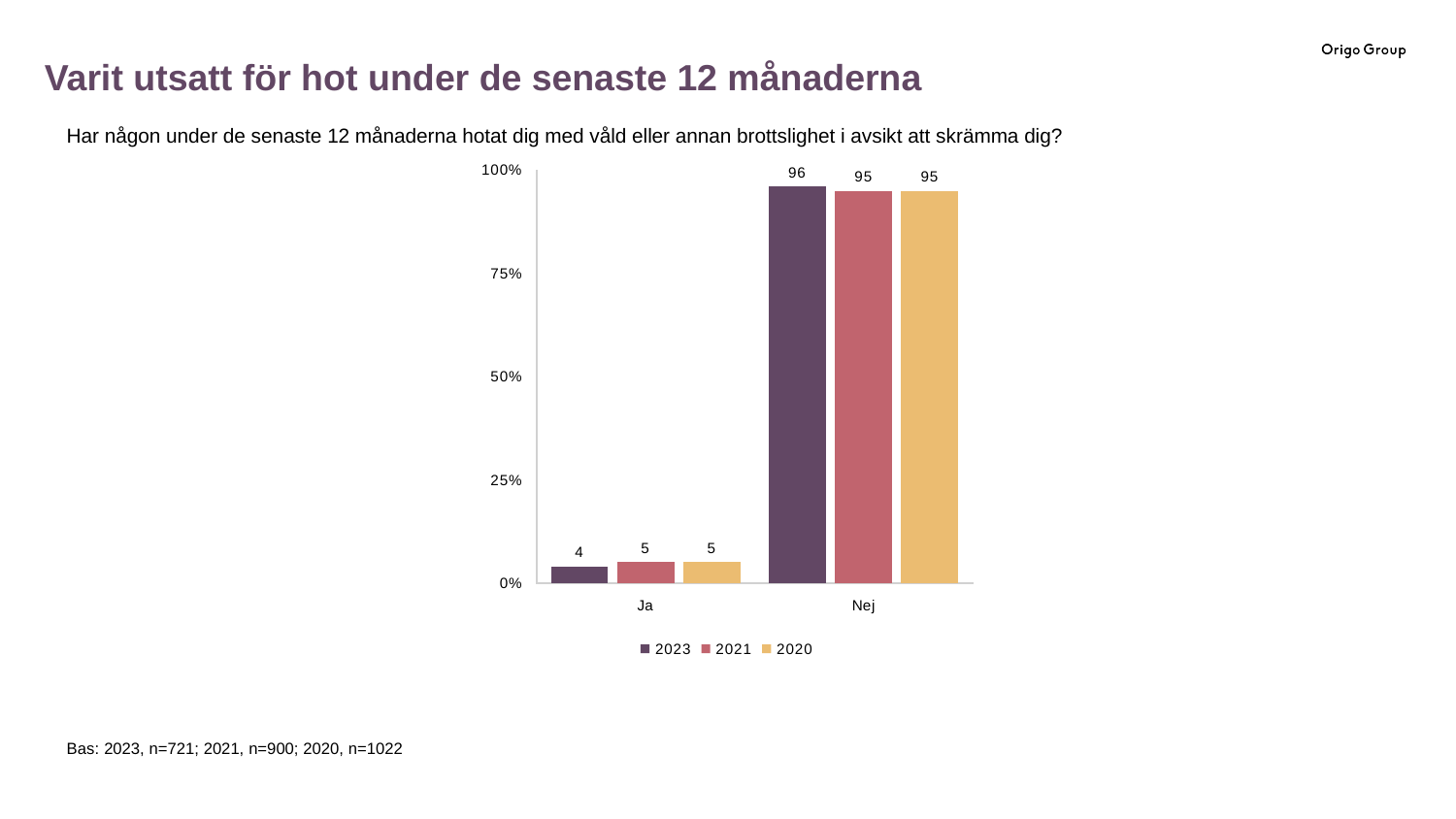
What is the value for 2021 in the Nej category? 95 What is the value for 2023 in the Nej category? 96 How many series does the legend list? 3 Which category has the lowest value for the 2021 series? Ja How many categories are shown on the x axis? 2 What is the value for 2023 in the Ja category? 4 What is the difference between the 2023 and 2021 values in the Nej category? 1 Which category has the highest value for the 2023 series? Nej Which is larger: the 2023 value for Ja or the 2021 value for Ja? 2021 value for Ja What is the value for 2020 in the Ja category? 5 Is the value for 2020 in the Nej category greater or less than 75%? greater What kind of chart is shown on the slide? Bar chart